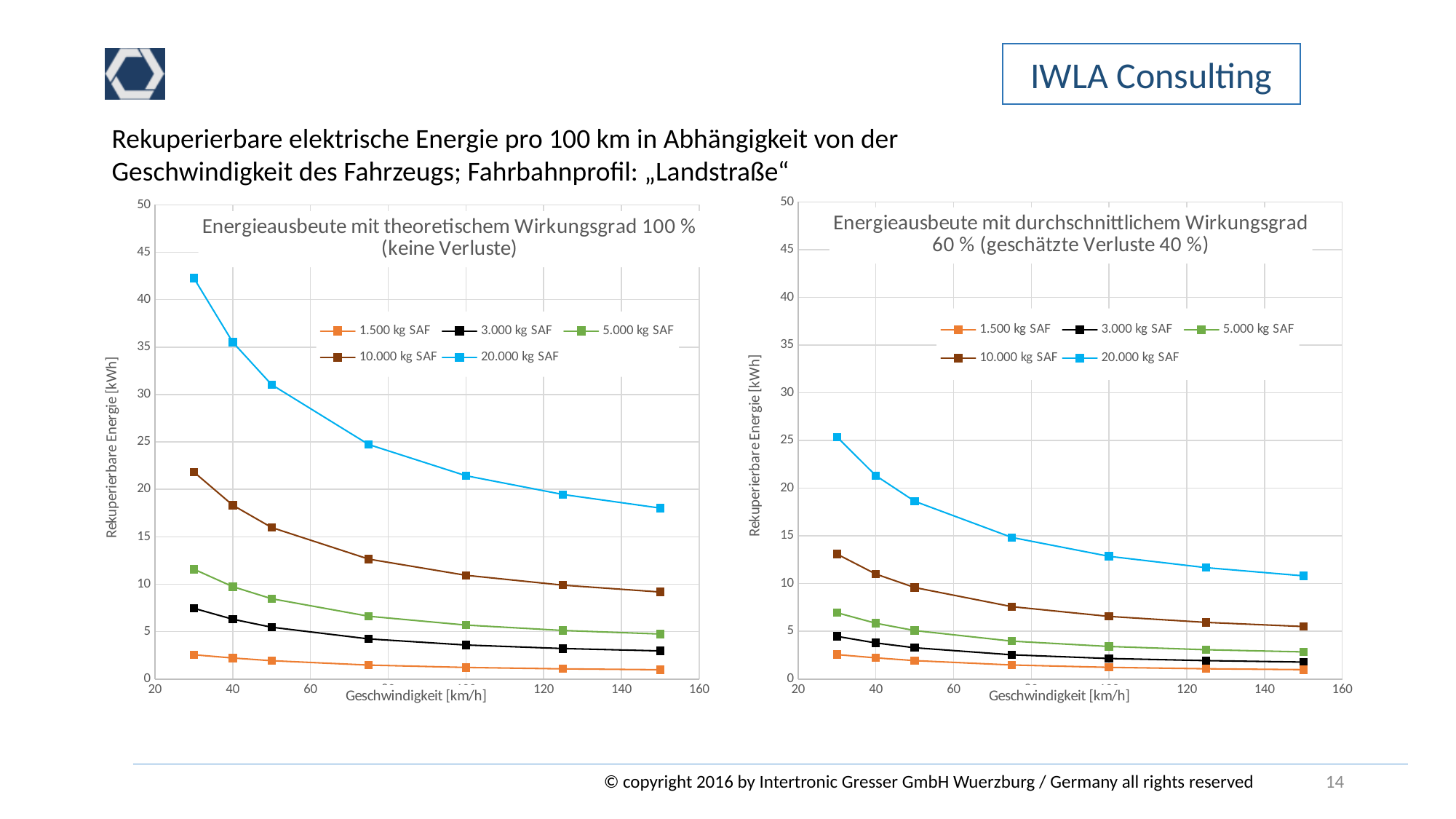
In the left chart, 'Energieausbeute mit theoretischem Wirkungsgrad 100 %', how many data points does the 20.000 kg SAF series have? 7 What is the y-axis label of the left chart, 'Energieausbeute mit theoretischem Wirkungsgrad 100 %'? Rekuperierbare Energie [kWh] In the right chart, 'Energieausbeute mit durchschnittlichem Wirkungsgrad 60 %', which is larger at 50 km/h: the value for 10.000 kg SAF or the value for 5.000 kg SAF? 10.000 kg SAF How many series does the legend of the right chart, 'Energieausbeute mit durchschnittlichem Wirkungsgrad 60 %', list? 5 In the right chart, 'Energieausbeute mit durchschnittlichem Wirkungsgrad 60 %', is the value for 20.000 kg SAF at 30 km/h greater or less than 20? greater In the left chart, 'Energieausbeute mit theoretischem Wirkungsgrad 100 %', is the value for 20.000 kg SAF at 150 km/h greater or less than 20? less In the left chart, 'Energieausbeute mit theoretischem Wirkungsgrad 100 %', which series has the highest value at 30 km/h? 20.000 kg SAF What kind of chart is the left chart, 'Energieausbeute mit theoretischem Wirkungsgrad 100 %'? line chart In the right chart, 'Energieausbeute mit durchschnittlichem Wirkungsgrad 60 %', is the value for 10.000 kg SAF at 30 km/h greater or less than 15? less In the right chart, 'Energieausbeute mit durchschnittlichem Wirkungsgrad 60 %', which series has the lowest value at 150 km/h? 1.500 kg SAF In the left chart, 'Energieausbeute mit theoretischem Wirkungsgrad 100 %', do the values of the 20.000 kg SAF series rise or fall as speed increases? fall